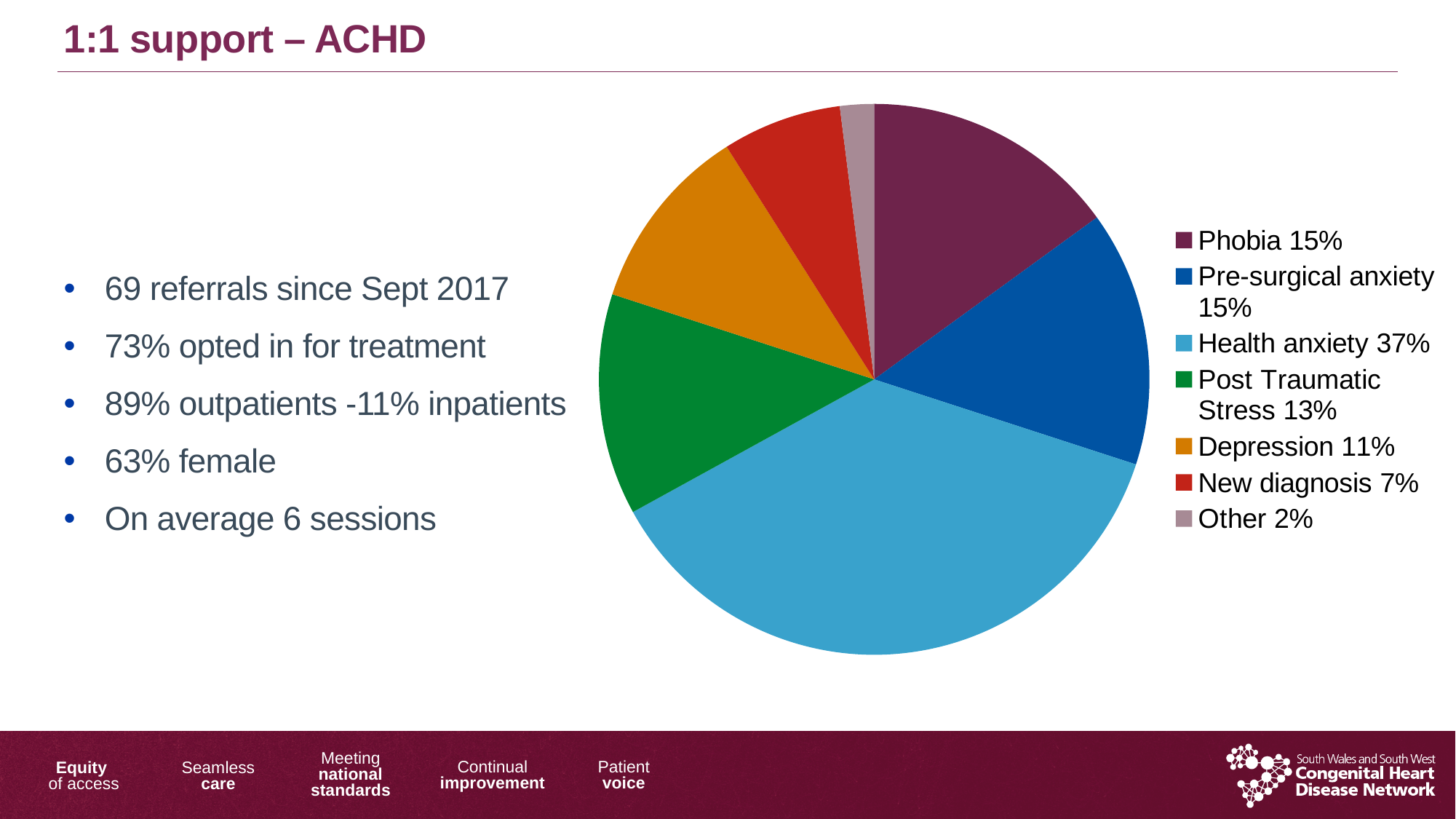
What percentage is shown for Depression in the legend? 11% What is the combined percentage of Phobia and Pre-surgical anxiety? 30% How many categories does the pie chart have? 7 What colour is the Health anxiety slice in the pie chart? light blue What kind of chart is shown on the slide? pie chart Which is larger, the slice for Depression or the slice for New diagnosis? Depression Which category has the largest slice of the pie? Health anxiety What percentage is shown for Post Traumatic Stress? 13% What is the difference in percentage points between Health anxiety and Phobia? 22 What percentage is shown for New diagnosis? 7% Which category has the smallest slice of the pie? Other What share of the pie does Health anxiety represent? 37%